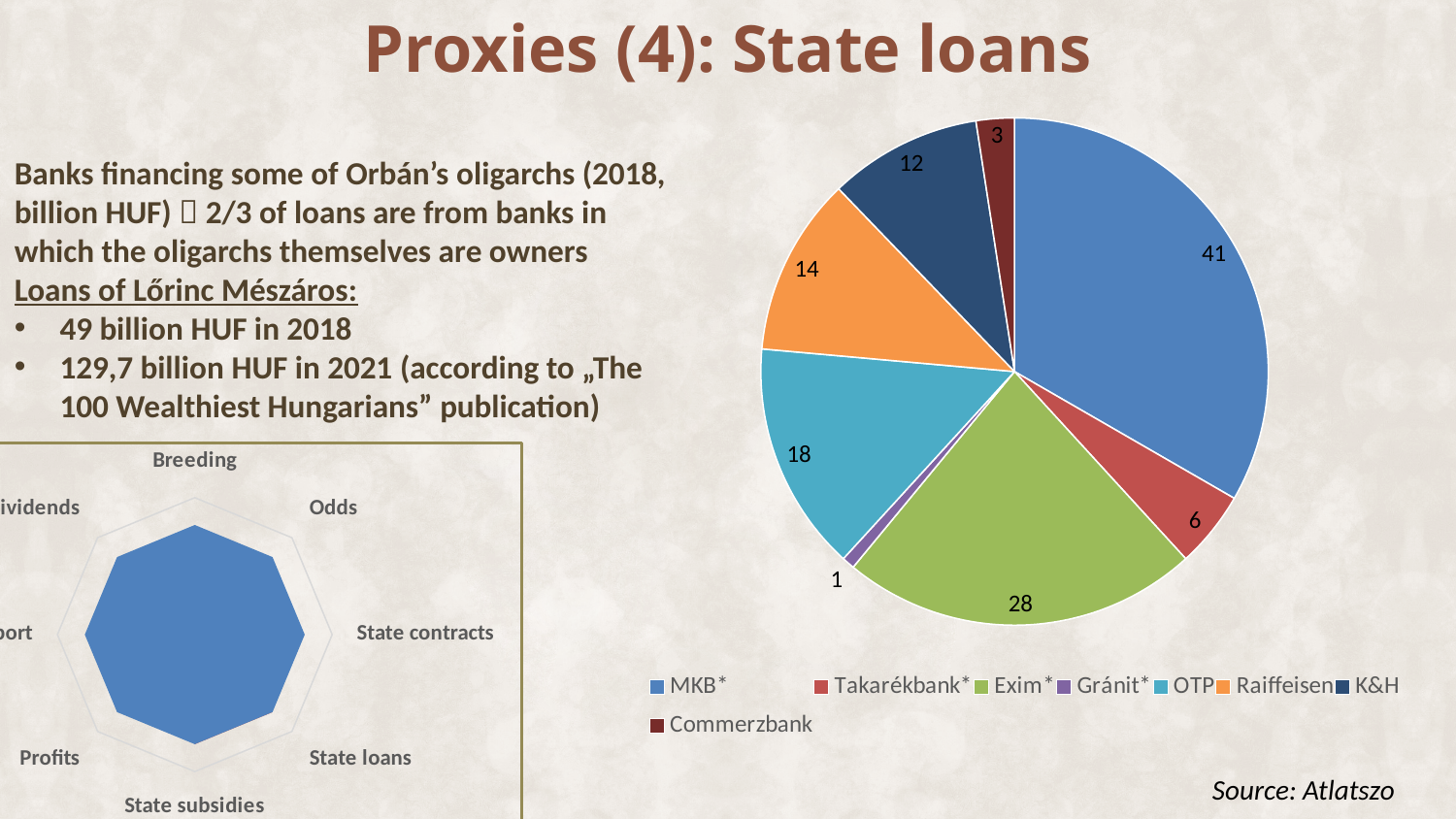
On the pie chart on the right, what is the difference between the values for MKB* and Exim*? 13 On the pie chart on the right, which bank has the largest slice? MKB* On the pie chart on the right, what is the value for Raiffeisen? 14 On the pie chart on the right, what is the value for Commerzbank? 3 On the pie chart on the right, what is the value for OTP? 18 What kind of chart is the chart in the lower left of the slide? Radar chart On the pie chart on the right, what is the value for MKB*? 41 On the pie chart on the right, which bank has the smallest slice? Gránit* On the pie chart on the right, what is the value for Exim*? 28 On the pie chart on the right, which is larger, the value for K&H or the value for Takarékbank*? K&H What kind of chart is the chart on the right of the slide? Pie chart How many banks does the legend of the pie chart on the right list? 8